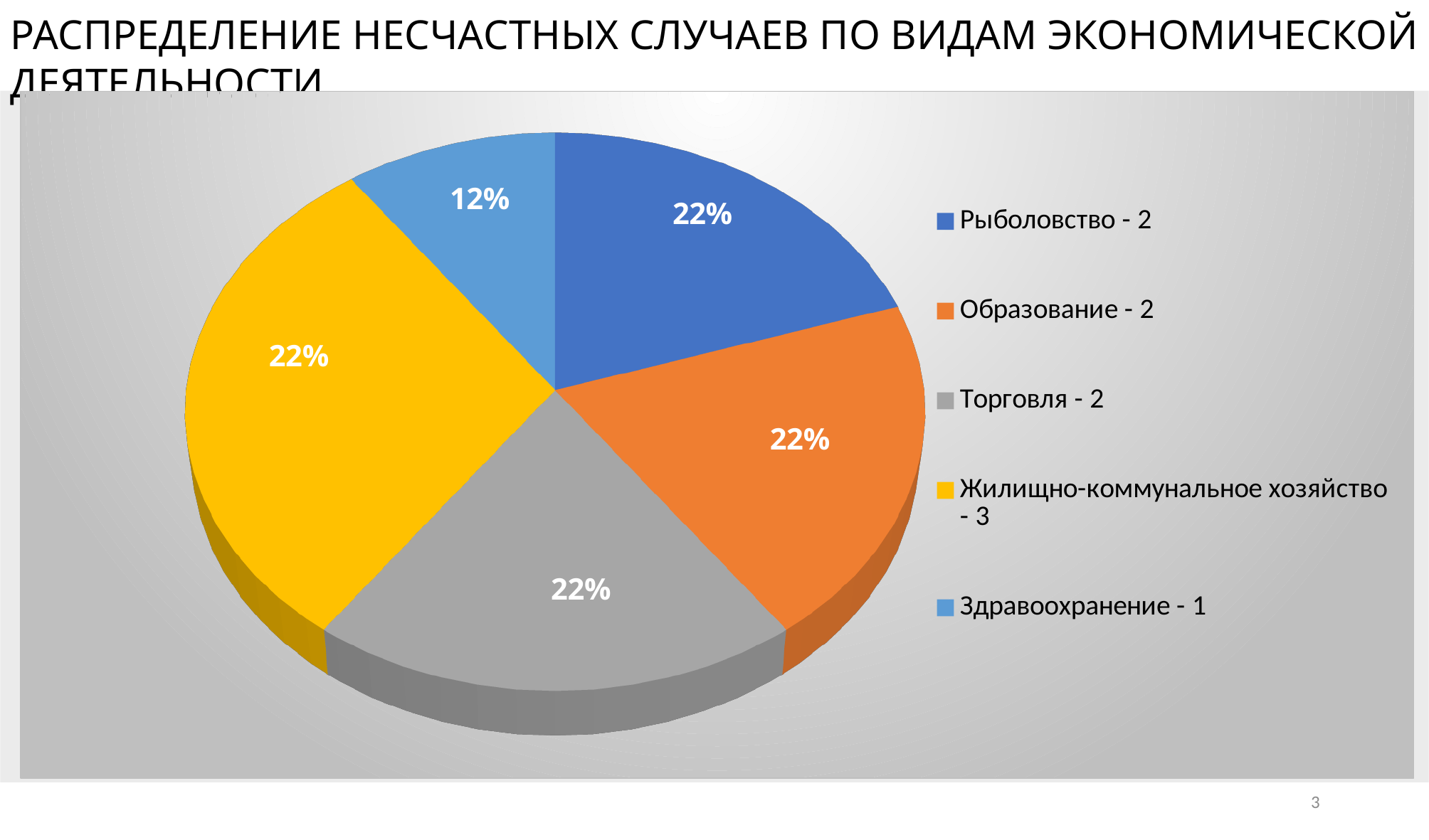
Which is larger, the share for Образование or the share for Здравоохранение? Образование What colour is the slice for Жилищно-коммунальное хозяйство? yellow What number is shown next to Здравоохранение in the legend? 1 What share of the pie is labelled for Торговля? 22% What share of the pie is labelled for Здравоохранение? 12% How many entries does the legend list? 5 What is the difference between the share labelled for Рыболовство and the share labelled for Здравоохранение? 10% What kind of chart is shown on the slide? pie chart How many slices does the pie chart have? 5 What number is shown next to Жилищно-коммунальное хозяйство in the legend? 3 Which category has the smallest share of the pie? Здравоохранение What share of the pie is labelled for Рыболовство? 22%